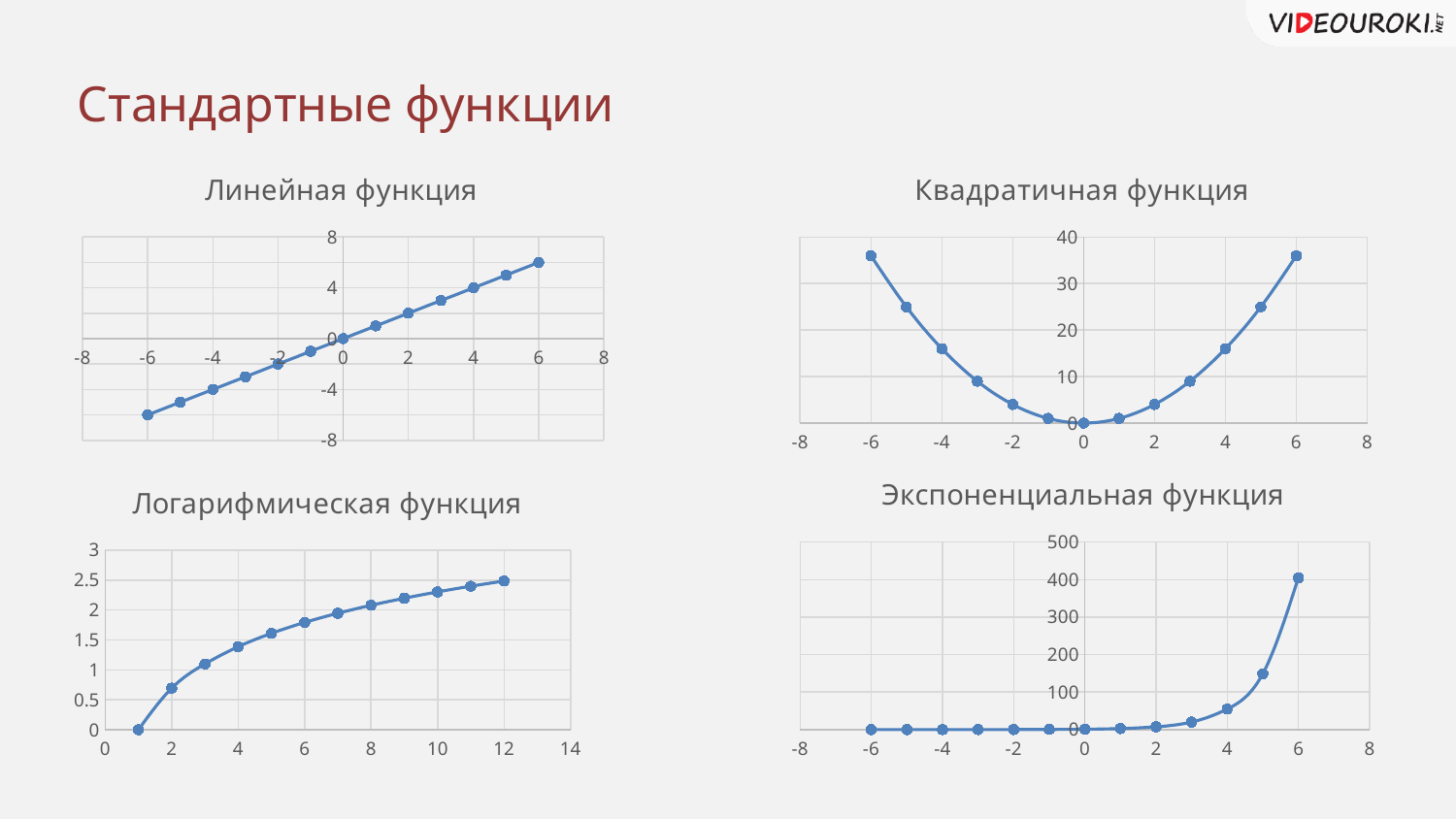
In the chart titled 'Квадратичная функция', is the value at x = 6 greater or less than 30? greater In the chart titled 'Линейная функция', how many data points are plotted? 13 How many charts are on the slide? 4 What kind of chart is the chart titled 'Экспоненциальная функция'? line chart In the chart titled 'Квадратичная функция', at which x value is the plotted value lowest? 0 What is the title of the chart in the top-left of the slide? Линейная функция In the chart titled 'Линейная функция', what is the y value of the point at x = 4? 4 In the chart titled 'Логарифмическая функция', is the value at x = 12 greater or less than 2? greater In the chart titled 'Квадратичная функция', is the value at x = -4 greater or less than 20? less In the chart titled 'Линейная функция', do the values rise or fall as x increases? rise In the chart titled 'Логарифмическая функция', how many data points are plotted? 12